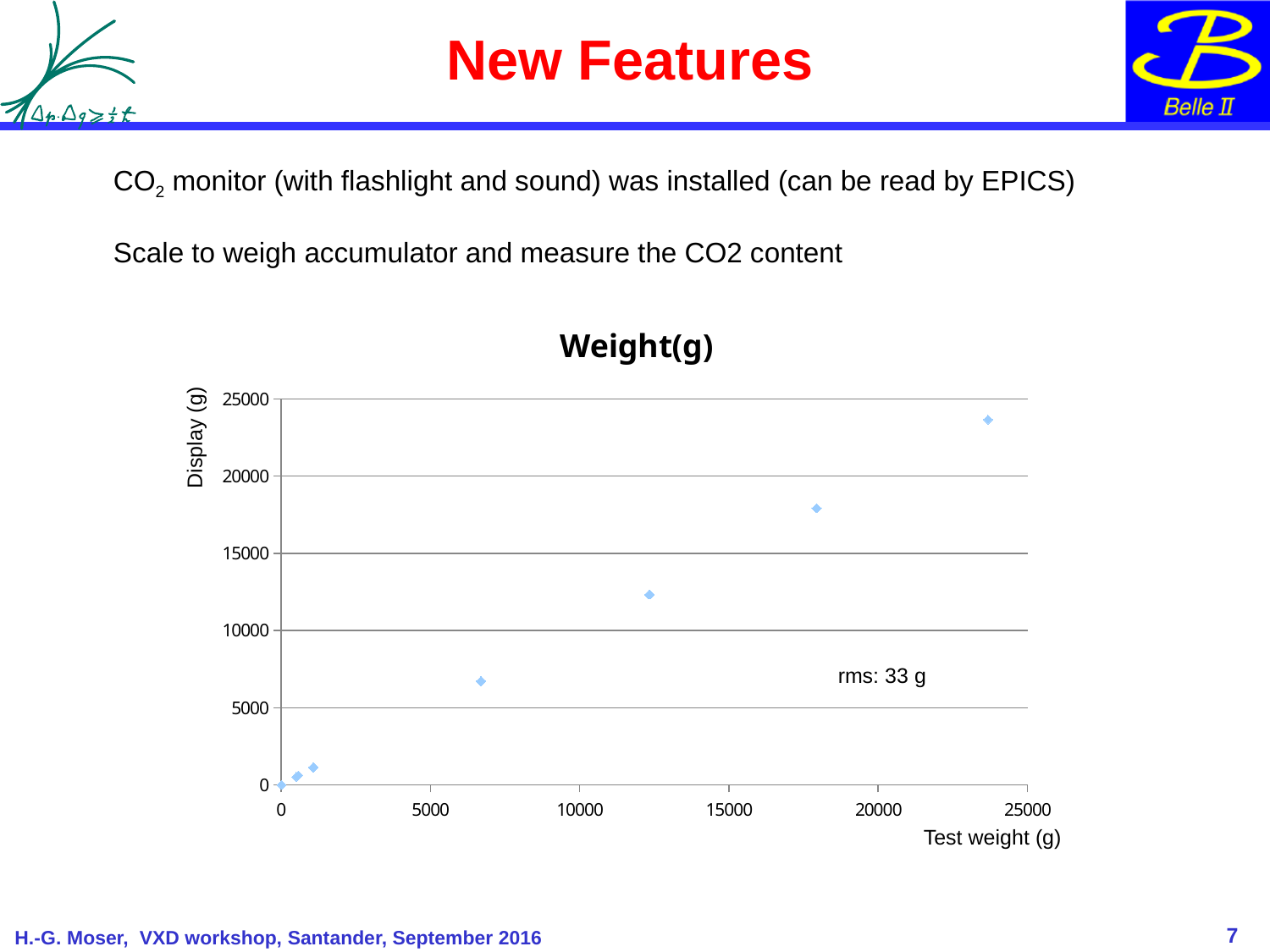
Do the Display (g) values rise or fall as Test weight (g) increases? rise What is the label of the x axis of the chart? Test weight (g) Is the Display (g) value for the point near a test weight of 18000 g greater or less than 20000? less What is the title of the chart? Weight(g) What rms value is annotated on the chart? rms: 33 g Which point has the higher Display (g) value: the one near a test weight of 18000 g or the one near 12300 g? the one near 18000 g Is the Display (g) value for the point near a test weight of 12300 g greater or less than 10000? greater What is the highest tick value shown on the y axis of the chart? 25000 Is the Display (g) value for the point near a test weight of 6700 g greater or less than 10000? less What kind of chart is shown on the slide? scatter chart